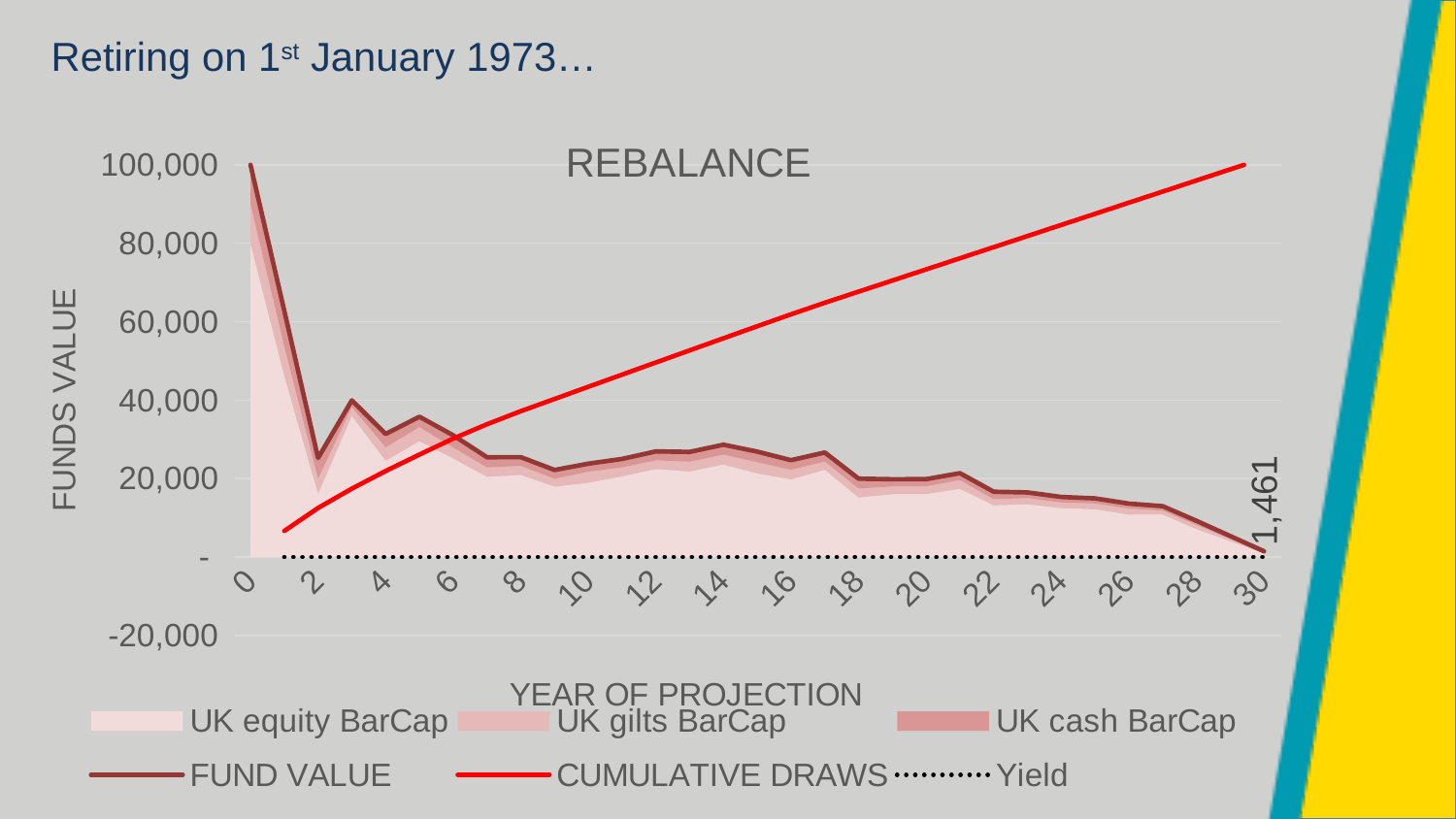
Is the FUND VALUE at year 2 greater or less than 40,000? less What is the label of the x axis? YEAR OF PROJECTION What is the title of the chart? REBALANCE What is the FUND VALUE at year 0 of projection? 100,000 What is the FUND VALUE at year 30 of projection? 1,461 At year 2, which is larger: FUND VALUE or CUMULATIVE DRAWS? FUND VALUE Does the CUMULATIVE DRAWS line rise or fall as the year of projection increases? rise Is the CUMULATIVE DRAWS value at year 10 greater or less than 20,000? greater At year 30, which is larger: FUND VALUE or CUMULATIVE DRAWS? CUMULATIVE DRAWS Is the CUMULATIVE DRAWS value at year 30 greater or less than 80,000? greater How many series does the chart's legend list? 6